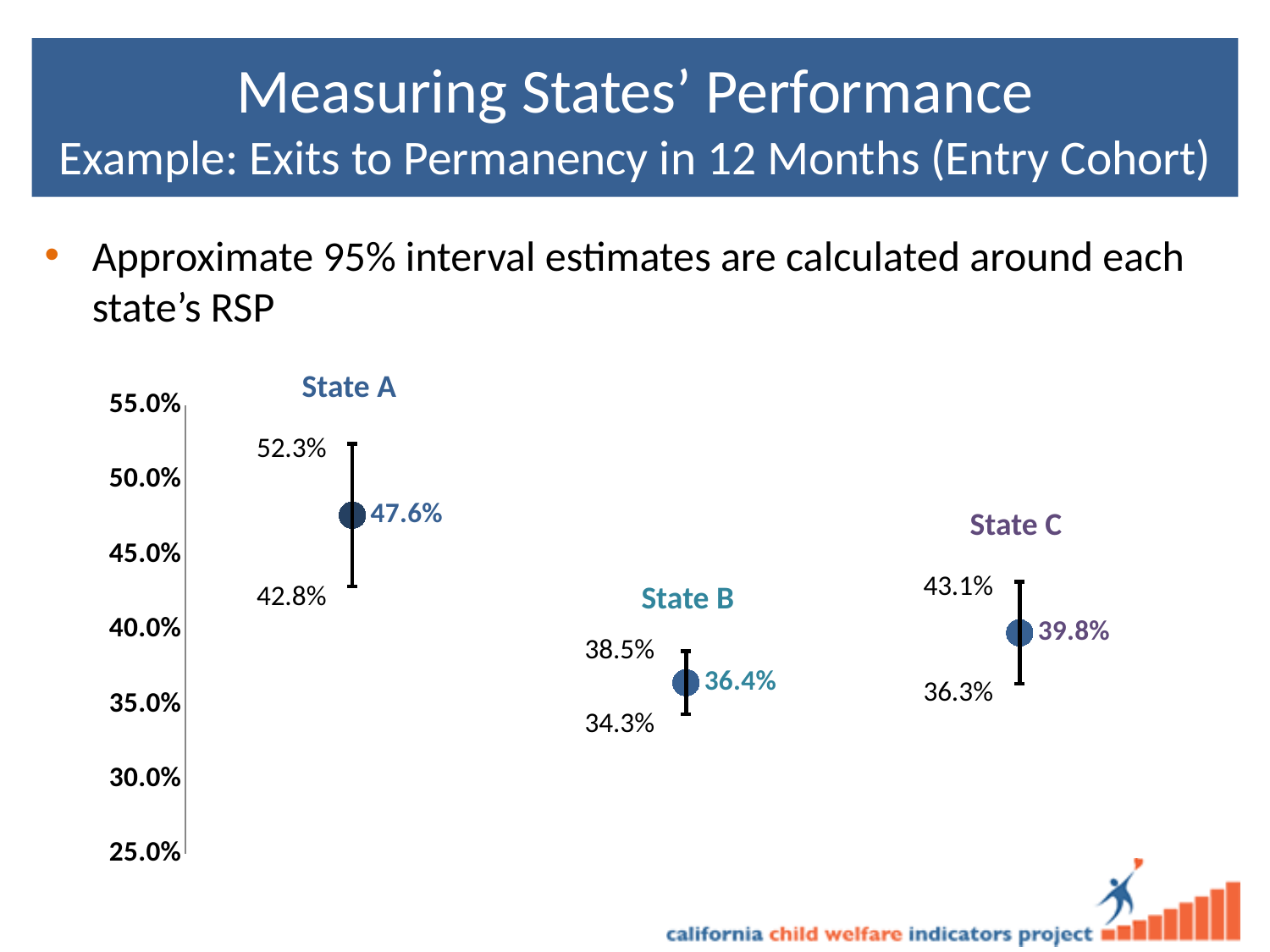
What is the point estimate (RSP) shown for State B? 36.4% What is the lower bound of the interval estimate for State C? 36.3% How many states are plotted on the chart? 3 Is the point estimate for State A greater or less than 45.0%? greater Which has a larger point estimate, State B or State C? State C What is the point estimate (RSP) shown for State C? 39.8% Which state has the lowest point estimate? State B What is the upper bound of the interval estimate for State A? 52.3% What is the difference between the point estimates of State A and State C? 7.8% Which state has the highest point estimate? State A What is the difference between the upper and lower bounds of State B's interval? 4.2% What is the point estimate (RSP) shown for State A? 47.6%